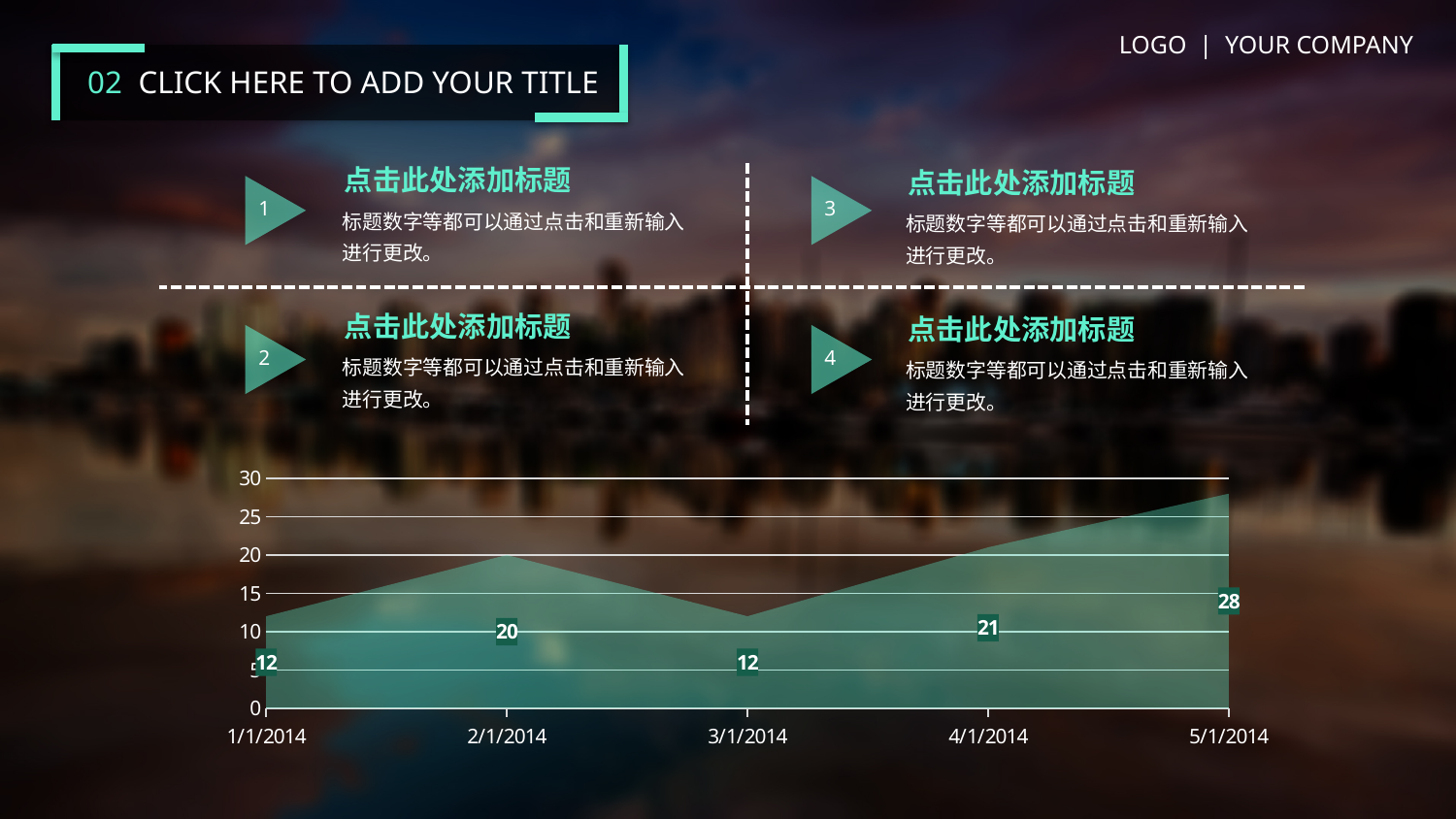
What is the value for 1/1/2014? 12 Is the value for 5/1/2014 greater or less than 25? greater Does the value rise or fall from 3/1/2014 to 5/1/2014? rise Which date has the highest value? 5/1/2014 What is the difference between the values for 5/1/2014 and 4/1/2014? 7 What is the value for 5/1/2014? 28 What is the difference between the values for 2/1/2014 and 3/1/2014? 8 What kind of chart is shown on the slide? area chart Which is larger, the value for 2/1/2014 or the value for 4/1/2014? 4/1/2014 What is the value for 4/1/2014? 21 What is the value for 2/1/2014? 20 How many data points are plotted on the chart? 5